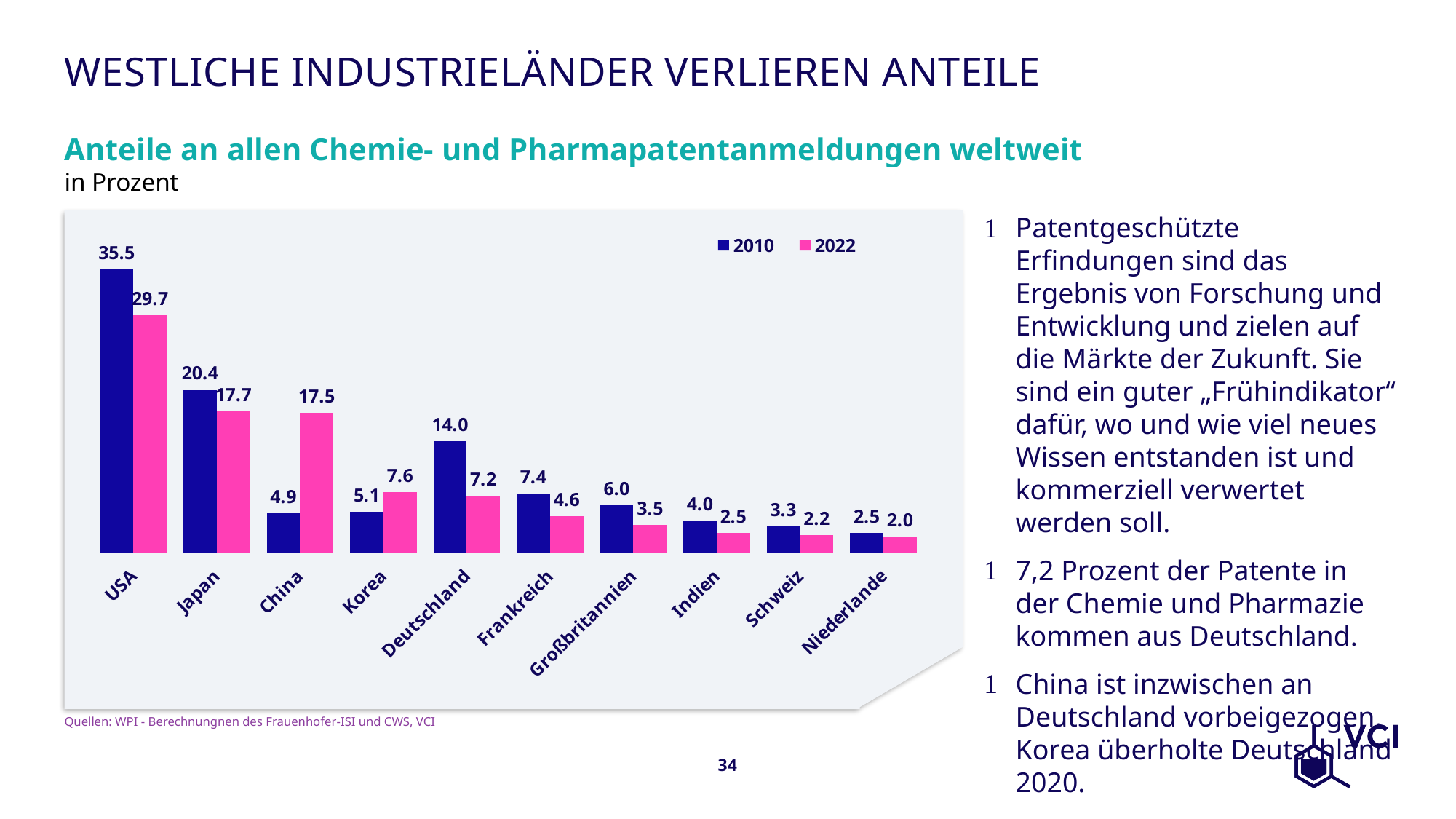
What was the USA's share of chemical and pharmaceutical patent applications in 2010? 35.5 How many countries are shown on the chart? 10 Which country had the lowest share in 2010? Niederlande Which was larger in 2022, the share of Korea or the share of Deutschland? Korea By how much did the USA's share fall from 2010 to 2022? 5.8 Which years are compared in the chart's legend? 2010 and 2022 How many series does the legend list? 2 By how much did China's share rise from 2010 to 2022? 12.6 What kind of chart is shown on the slide? Bar chart Which country had the highest share in 2022? USA What was China's share in 2022? 17.5 What was Deutschland's share in 2022? 7.2